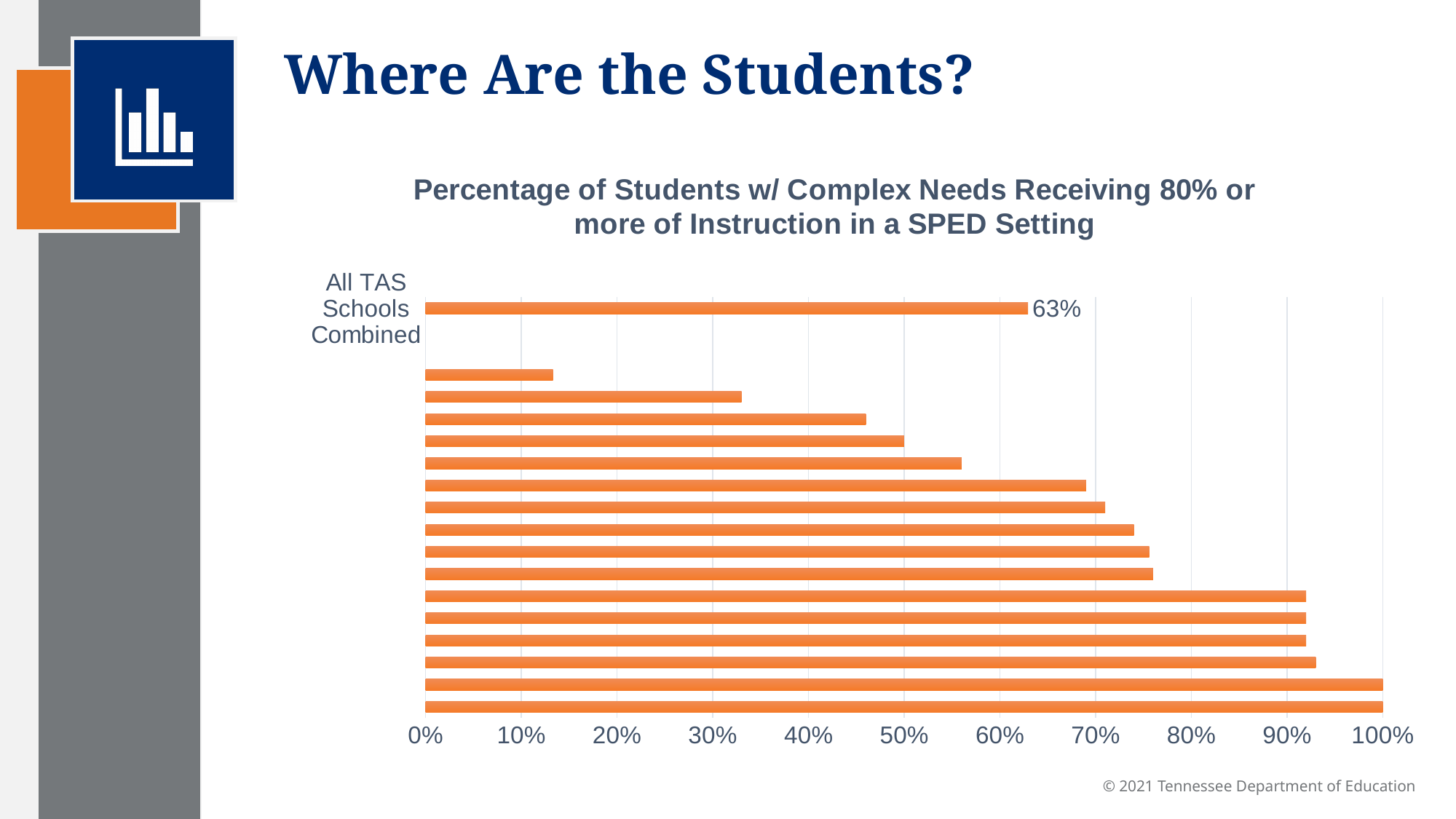
Is the shortest bar in the chart greater or less than 20%? less How many bars are plotted in the chart? 17 What is the value for All TAS Schools Combined? 63% What is the title of the chart? Percentage of Students w/ Complex Needs Receiving 80% or more of Instruction in a SPED Setting What value do the longest bars in the chart reach? 100% What is the highest value shown on the horizontal axis? 100% Is the value for All TAS Schools Combined greater or less than 70%? less What kind of chart is shown on the slide? bar chart Which is larger: the value for All TAS Schools Combined or the shortest bar in the chart? All TAS Schools Combined How many bars reach 100%? 2 Is the value for All TAS Schools Combined greater or less than 60%? greater